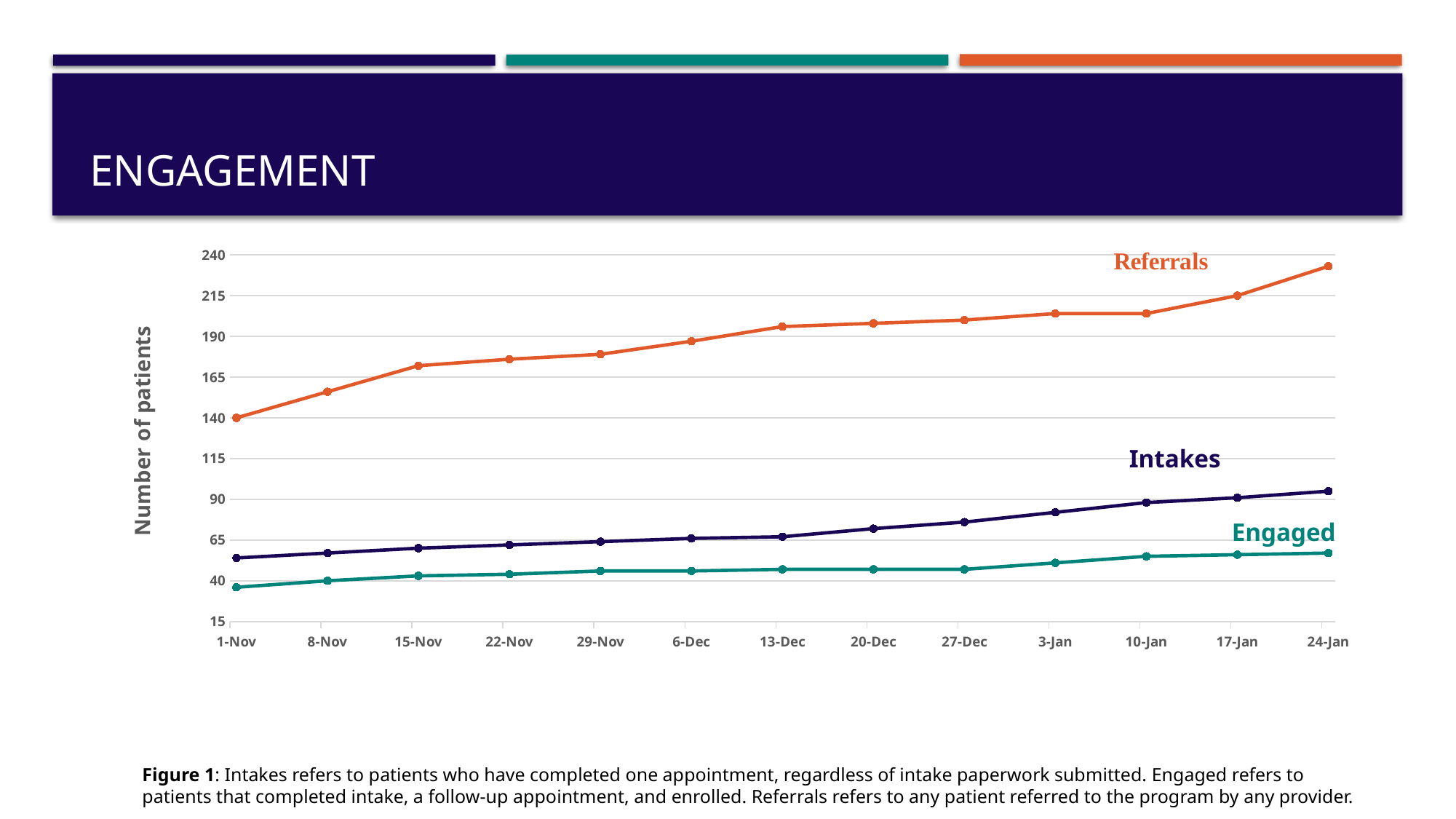
How many series are plotted on the chart? 3 Which series has the highest values across the chart? Referrals On 24-Jan, which is larger: Intakes or Engaged? Intakes What kind of chart is shown on the slide? line chart Do the Referrals values rise or fall from 1-Nov to 24-Jan? rise How many dates are shown along the x axis of the chart? 13 Is the value for Engaged on 1-Nov greater or less than 40? less Is the value for Referrals on 24-Jan greater or less than 215? greater What is the value for Referrals on 1-Nov? 140 Is the value for Intakes on 24-Jan greater or less than 90? greater What is the title of the y axis? Number of patients